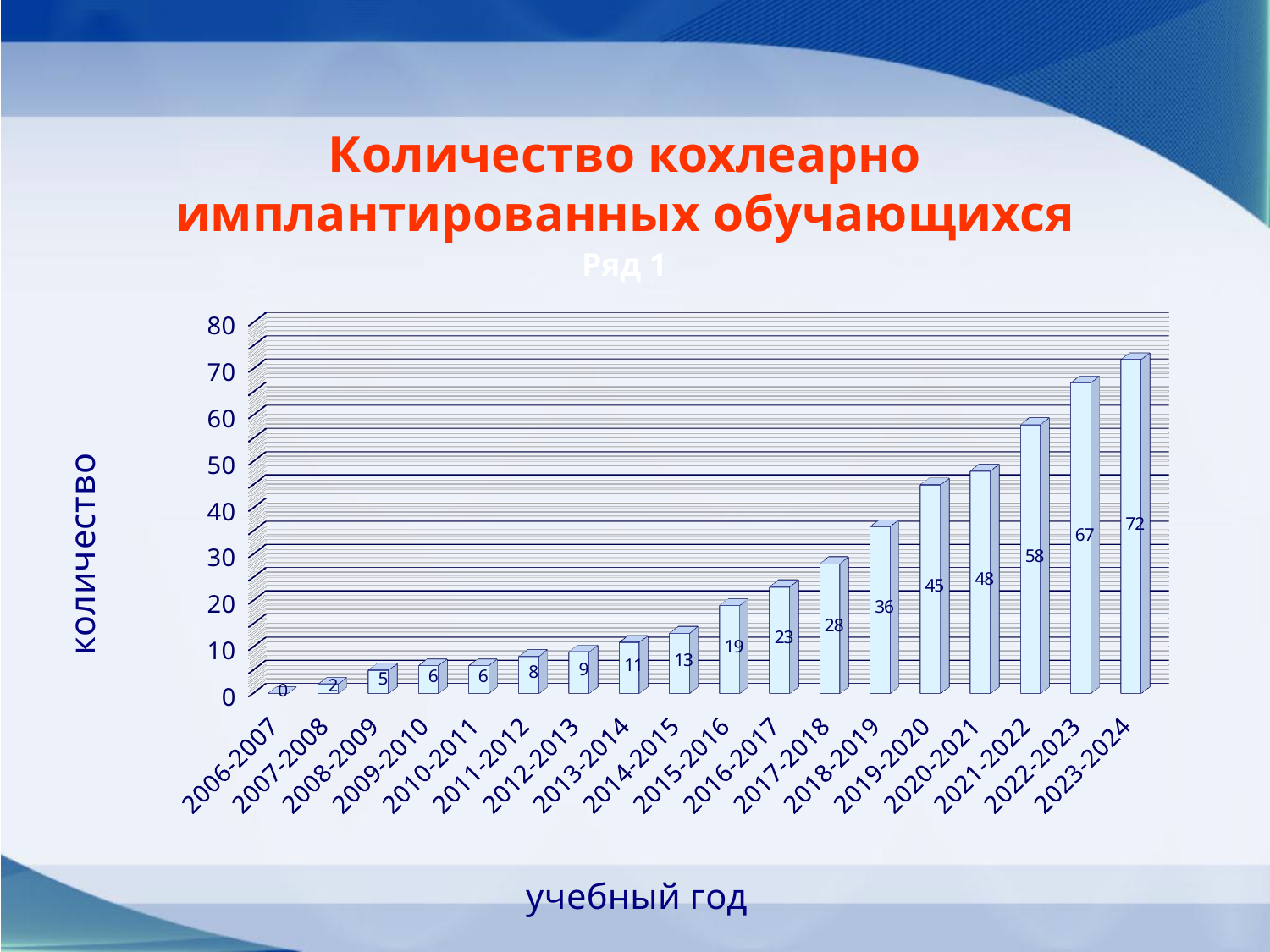
Which is larger, the value for 2018-2019 or the value for 2017-2018? 2018-2019 What is the value for 2023-2024? 72 Which academic year has the highest value? 2023-2024 Do the values rise or fall from 2006-2007 to 2023-2024? rise How many academic years are shown on the x axis? 18 What is the difference between the values for 2023-2024 and 2006-2007? 72 What kind of chart is shown on the slide? bar chart What is the difference between the values for 2022-2023 and 2021-2022? 9 What is the title of the chart? Ряд 1 What is the value for 2015-2016? 19 What is the value for 2019-2020? 45 Which academic year has the lowest value? 2006-2007